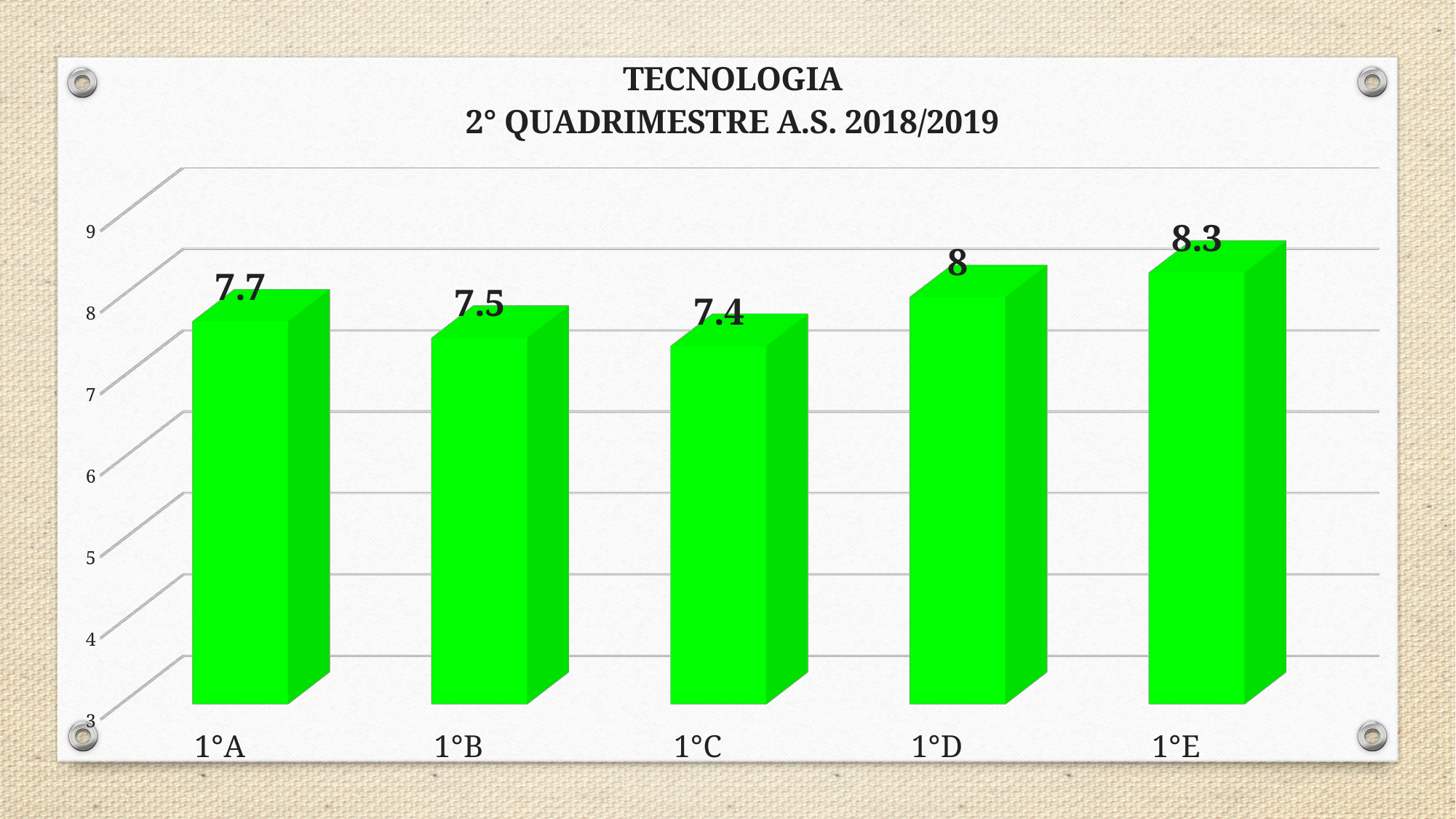
Which class has the highest value? 1°E What is the value for 1°D? 8 What is the difference between the values for 1°D and 1°B? 0.5 What is the value for 1°A? 7.7 Is the value for 1°E greater or less than 8? greater How many classes are shown on the chart? 5 What is the title of the chart? TECNOLOGIA 2° QUADRIMESTRE A.S. 2018/2019 Which class has the lowest value? 1°C What kind of chart is shown on the slide? bar chart Which is larger, the value for 1°A or the value for 1°B? 1°A What is the value for 1°C? 7.4 What is the difference between the values for 1°E and 1°C? 0.9